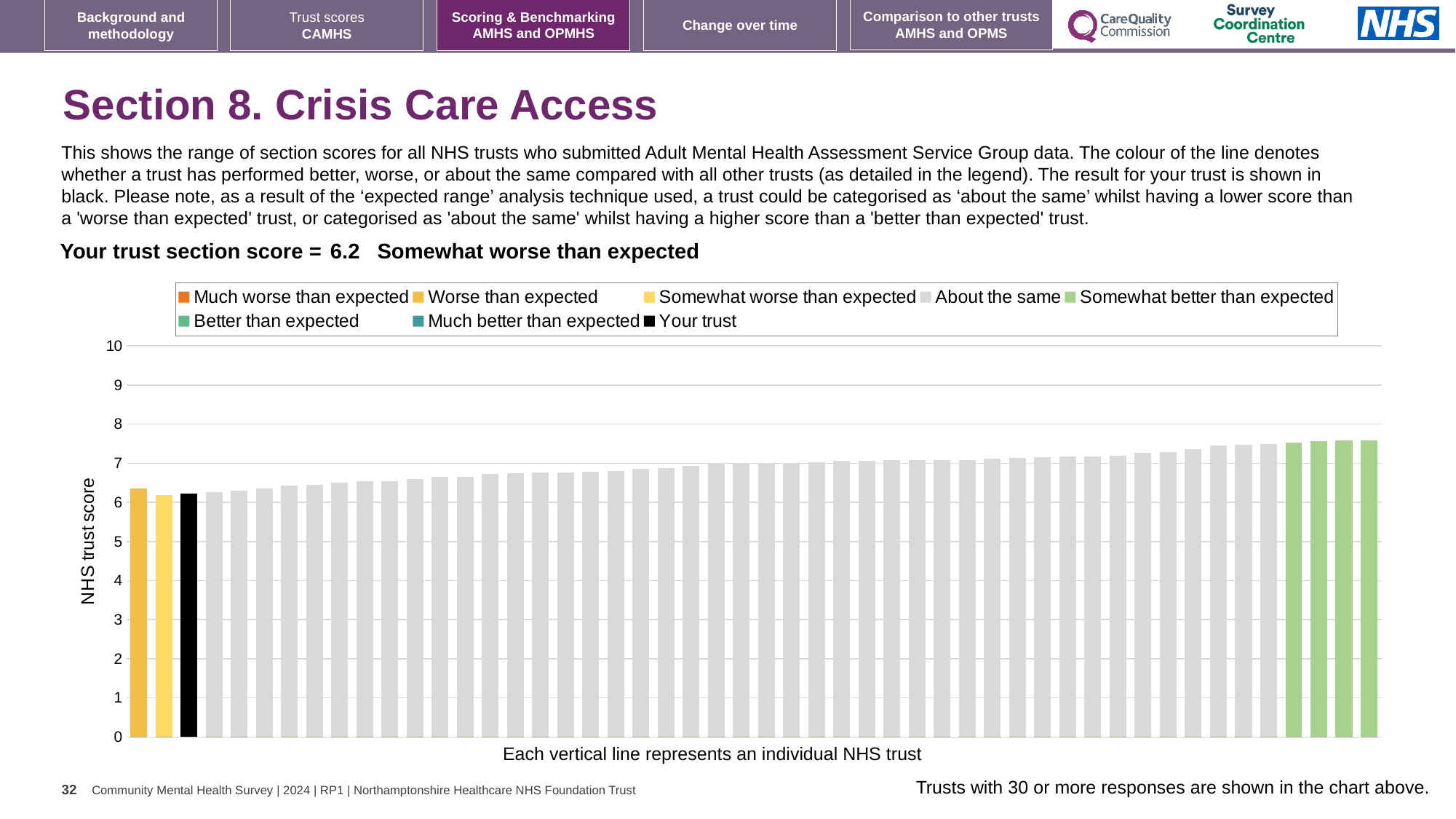
Which is larger, the rightmost bar or the bar for your trust? the rightmost bar How many entries does the chart legend list? 8 Is the value for your trust greater or less than 7? less What is the section score for your trust? 6.2 Is the value for your trust greater or less than 6? greater What kind of chart is shown on the slide? bar chart What is the label on the y axis of the chart? NHS trust score Do the bar values rise or fall from left to right along the x axis? rise Is the value of the lowest bar greater or less than 5? greater Which category is your trust's section score placed in? Somewhat worse than expected How many bars are shown in the 'Somewhat better than expected' colour (green)? 4